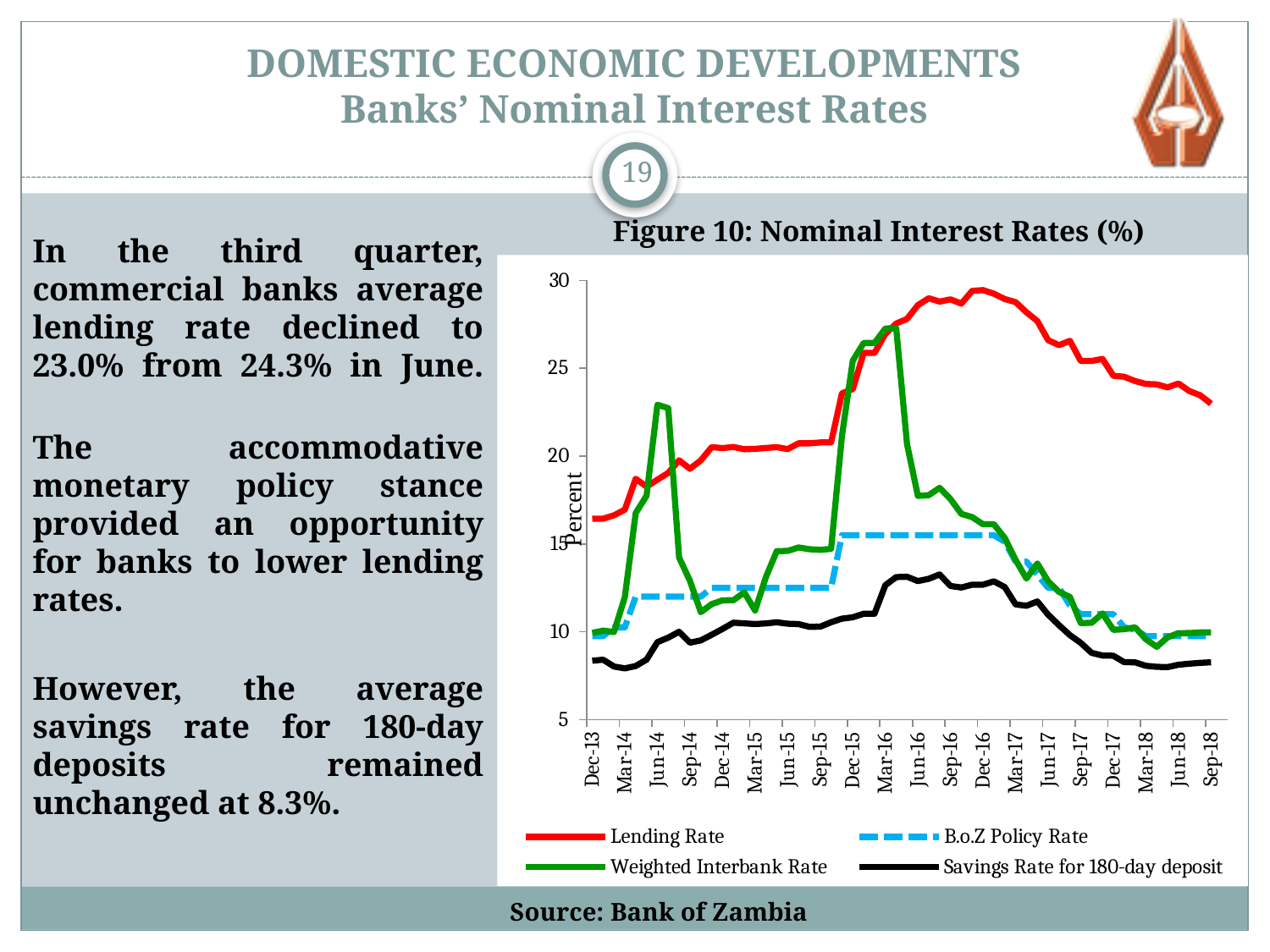
In Figure 10, does the Lending Rate rise or fall between Dec-16 and Sep-18? fall In Figure 10, is the B.o.Z Policy Rate at Mar-15 greater or less than 15? less In Figure 10, is the Weighted Interbank Rate at Jun-14 greater or less than 20? greater In Figure 10, is the Savings Rate for 180-day deposit at Sep-18 greater or less than 10? less What kind of chart is Figure 10: Nominal Interest Rates (%)? line chart What is the title of the chart on the slide? Figure 10: Nominal Interest Rates (%) What colour is the Lending Rate line in Figure 10? red How many series does the legend of Figure 10 list? 4 In Figure 10, which series has the lowest value at Sep-18? Savings Rate for 180-day deposit In Figure 10, which is larger at Sep-18: the Lending Rate or the Savings Rate for 180-day deposit? Lending Rate